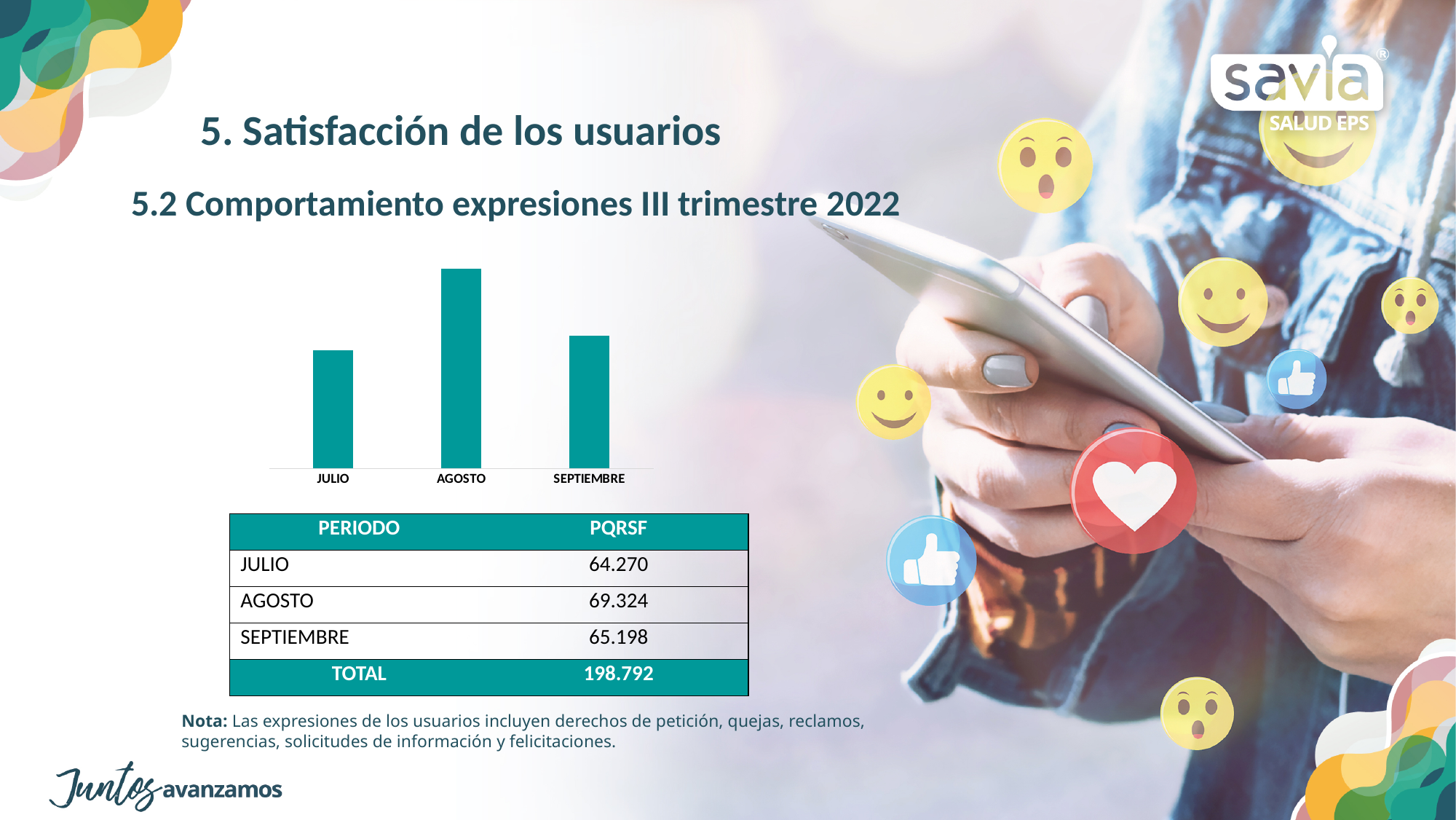
How many categories (months) does the bar chart show? 3 According to the table, what is the PQRSF value for AGOSTO? 69.324 According to the table, what is the PQRSF value for SEPTIEMBRE? 65.198 Which month has the lowest bar in the chart? JULIO What is the title of the section containing the chart? 5.2 Comportamiento expresiones III trimestre 2022 According to the table, what is the PQRSF value for JULIO? 64.270 Which month has the highest bar in the chart? AGOSTO Is the bar for SEPTIEMBRE taller or shorter than the bar for JULIO? taller What is the difference between the PQRSF values for SEPTIEMBRE and JULIO? 928 What is the difference between the PQRSF values for AGOSTO and JULIO? 5.054 What kind of chart is shown on the slide? bar chart What is the TOTAL PQRSF shown in the table for the three months? 198.792